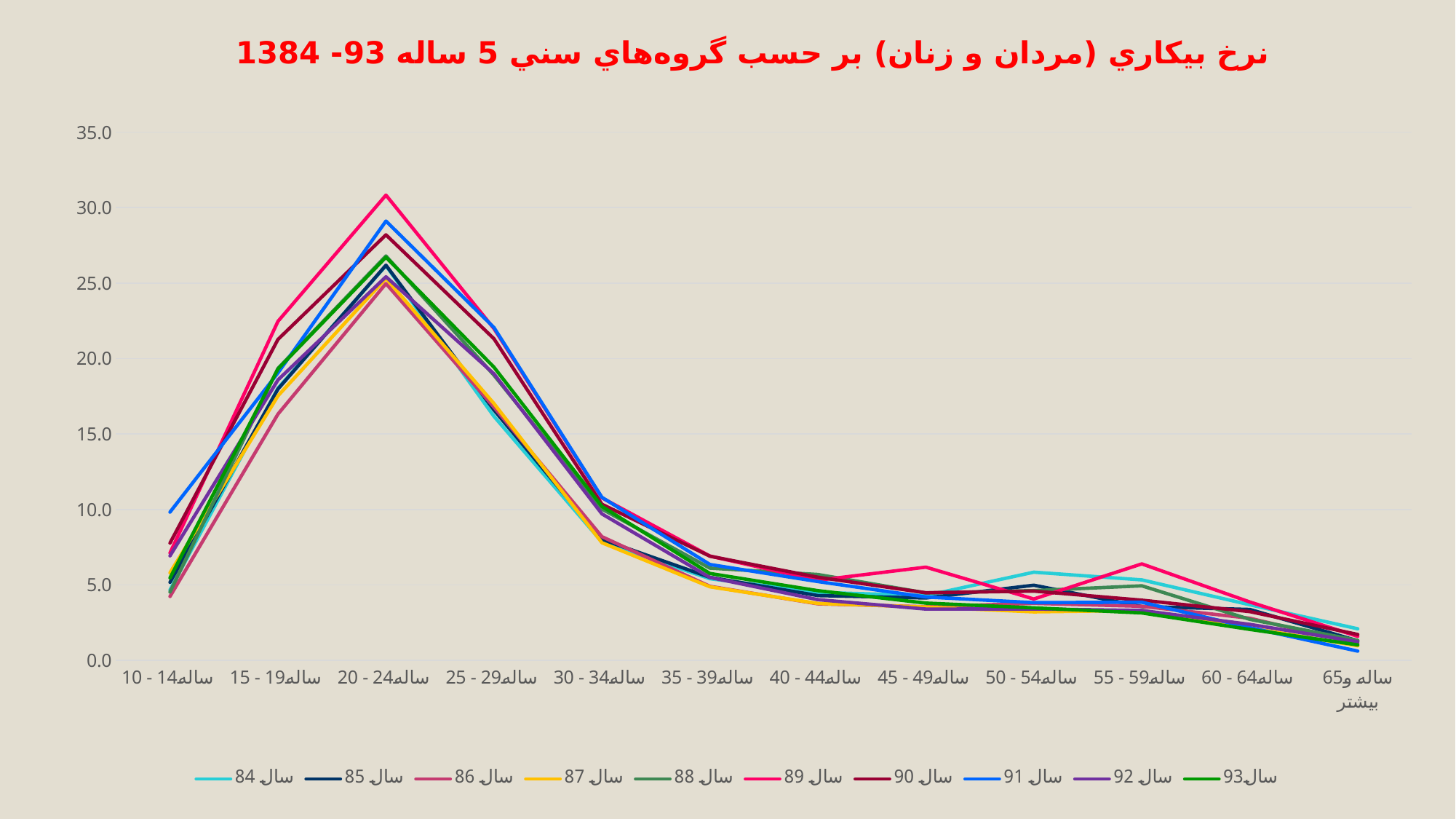
Which age group has the highest value for the series سال 89? 20 - 24 ساله Is the value for سال 89 at 15 - 19 ساله greater or less than 20? greater What kind of chart is shown on the slide? line chart Is the value for سال 89 at 20 - 24 ساله greater or less than 30? greater How many age-group categories are shown on the x axis? 12 Is the value for سال 84 at 30 - 34 ساله greater or less than 10? less Which series has the highest value at the 10 - 14 ساله age group? سال 91 Which series has the highest value at the 20 - 24 ساله age group? سال 89 How many series does the legend list? 10 From the 20 - 24 ساله group to the 65 ساله و بیشتر group, do the values for سال 91 rise or fall? fall What is the highest tick value shown on the vertical axis? 35.0